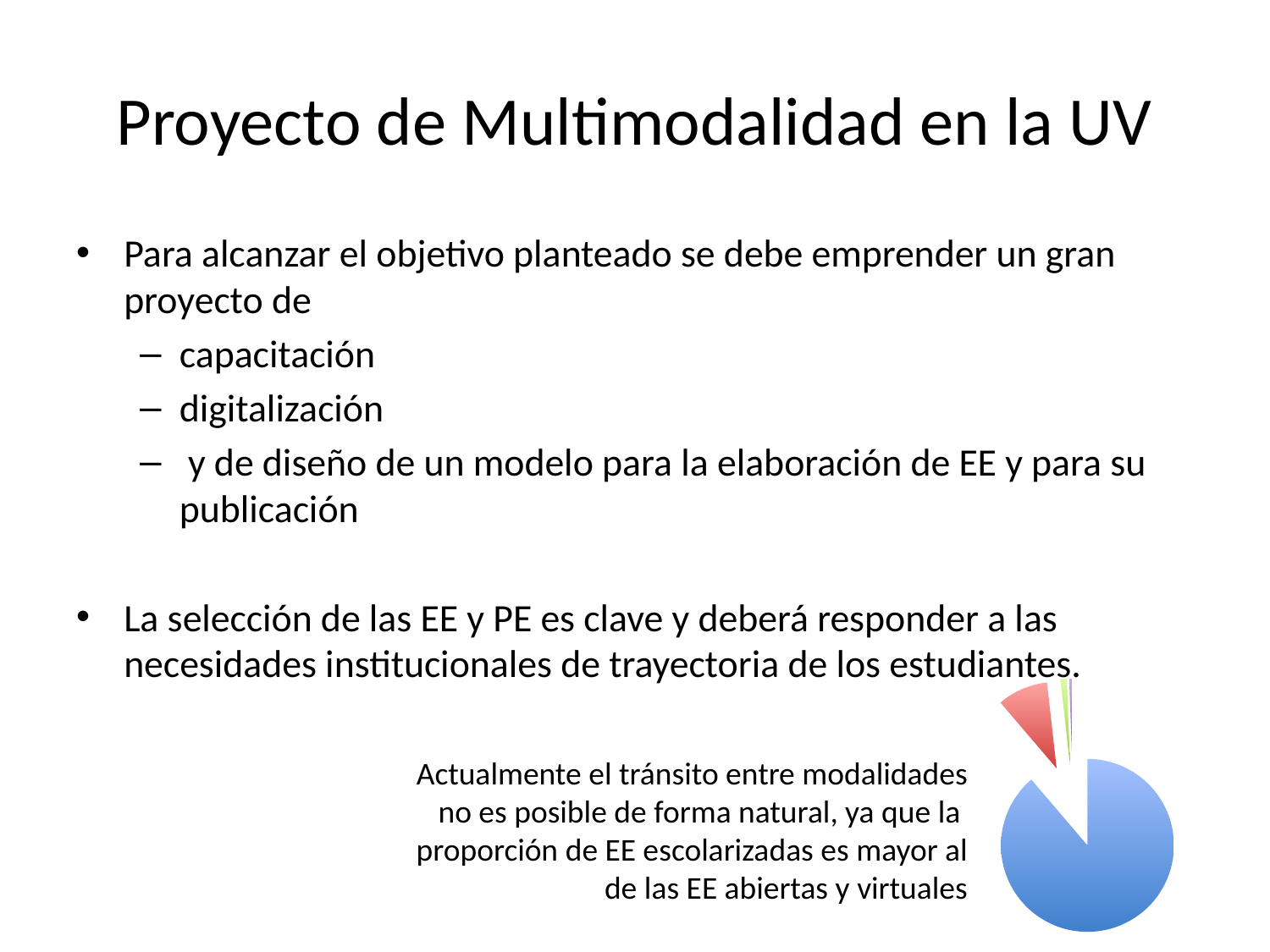
Which colour slice is the largest in the pie chart? blue What kind of chart is shown at the bottom right of the slide? pie chart How many slices does the pie chart have? 4 Does the pie chart display a legend? No In the pie chart, which is larger, the blue slice or the red slice? blue Does the pie chart show data labels on its slices? No